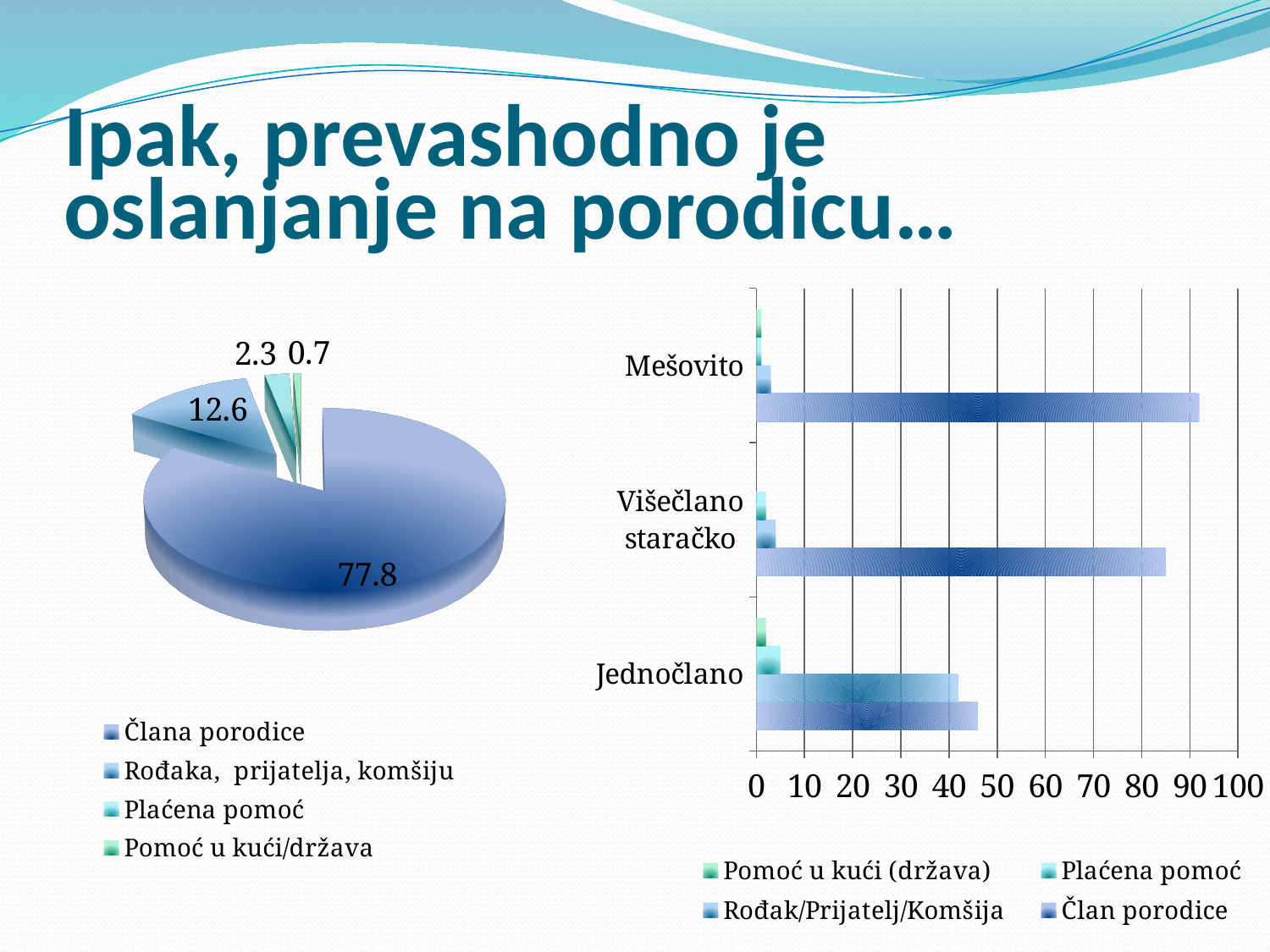
On the pie chart on the left, what value is shown for Plaćena pomoć? 2.3 On the pie chart on the left, which category has the smallest slice? Pomoć u kući/država On the pie chart on the left, what is the difference between the values for Člana porodice and Rođaka, prijatelja, komšiju? 65.2 On the bar chart on the right, which category has the highest Član porodice value? Mešovito On the bar chart on the right, is the Član porodice value for Mešovito greater or less than 80? greater On the pie chart on the left, how many slices are there? 4 What kind of chart is on the right side of the slide? Bar chart On the bar chart on the right, how many series does the legend list? 4 On the pie chart on the left, what value is shown for Rođaka, prijatelja, komšiju? 12.6 On the bar chart on the right, is the Član porodice value for Jednočlano greater or less than 50? less On the pie chart on the left, what value is shown for Pomoć u kući/država? 0.7 On the pie chart on the left, what value is shown for Člana porodice? 77.8